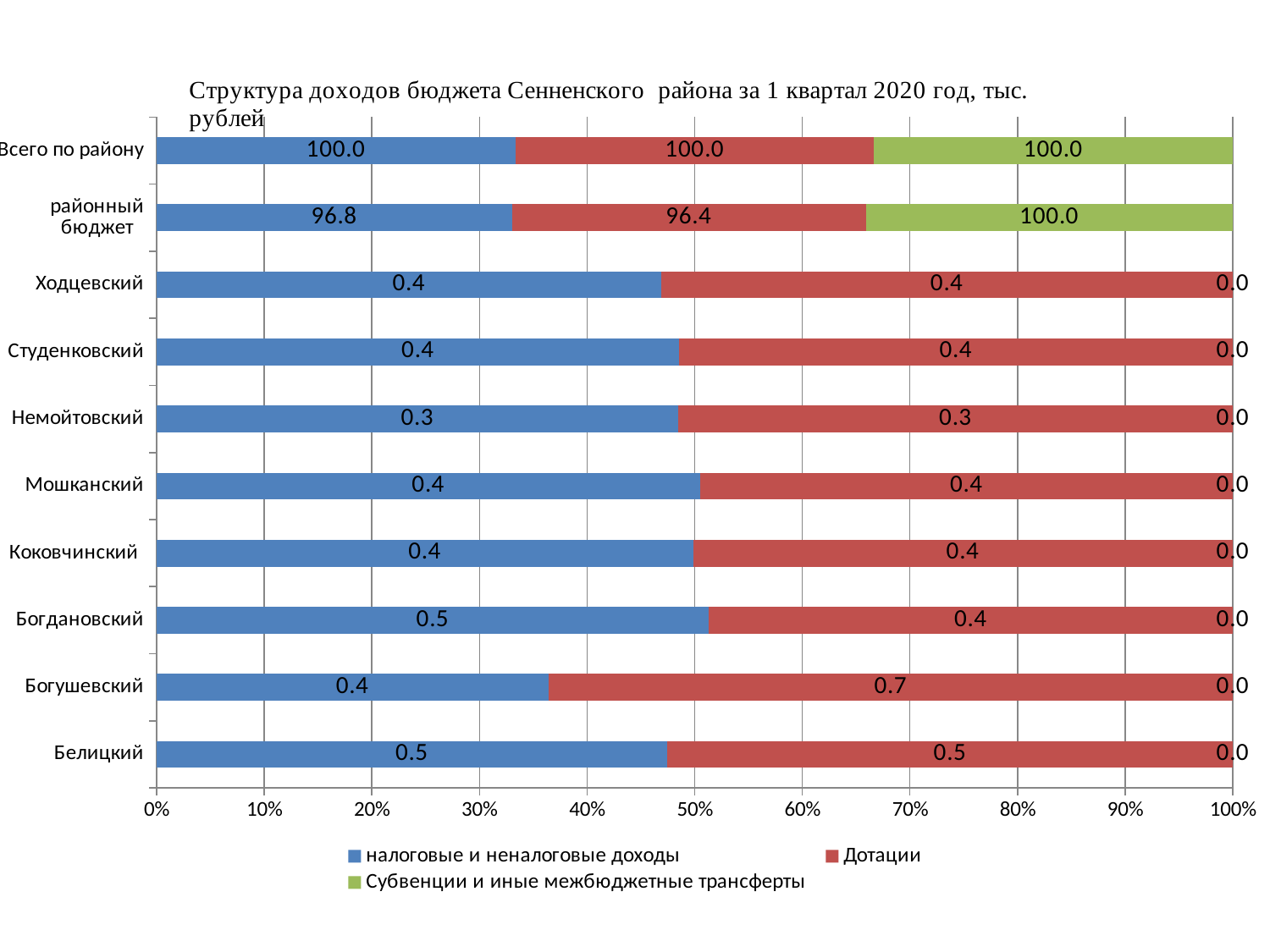
What kind of chart is shown on the slide? Stacked bar chart What is the value for Дотации for районный бюджет? 96.4 Which category has the highest value for Дотации? Всего по району What is the value for налоговые и неналоговые доходы for районный бюджет? 96.8 How many categories are shown on the vertical axis? 10 What is the difference between the налоговые и неналоговые доходы values for Всего по району and районный бюджет? 3.2 What is the value for Субвенции и иные межбюджетные трансферты for Всего по району? 100.0 What colour represents Дотации in the legend? Red What is the difference between the налоговые и неналоговые доходы value and the Дотации value for районный бюджет? 0.4 What is the value for Дотации for Богушевский? 0.7 Which is larger, the Дотации value for Богушевский or for Белицкий? Богушевский How many series does the legend list? 3